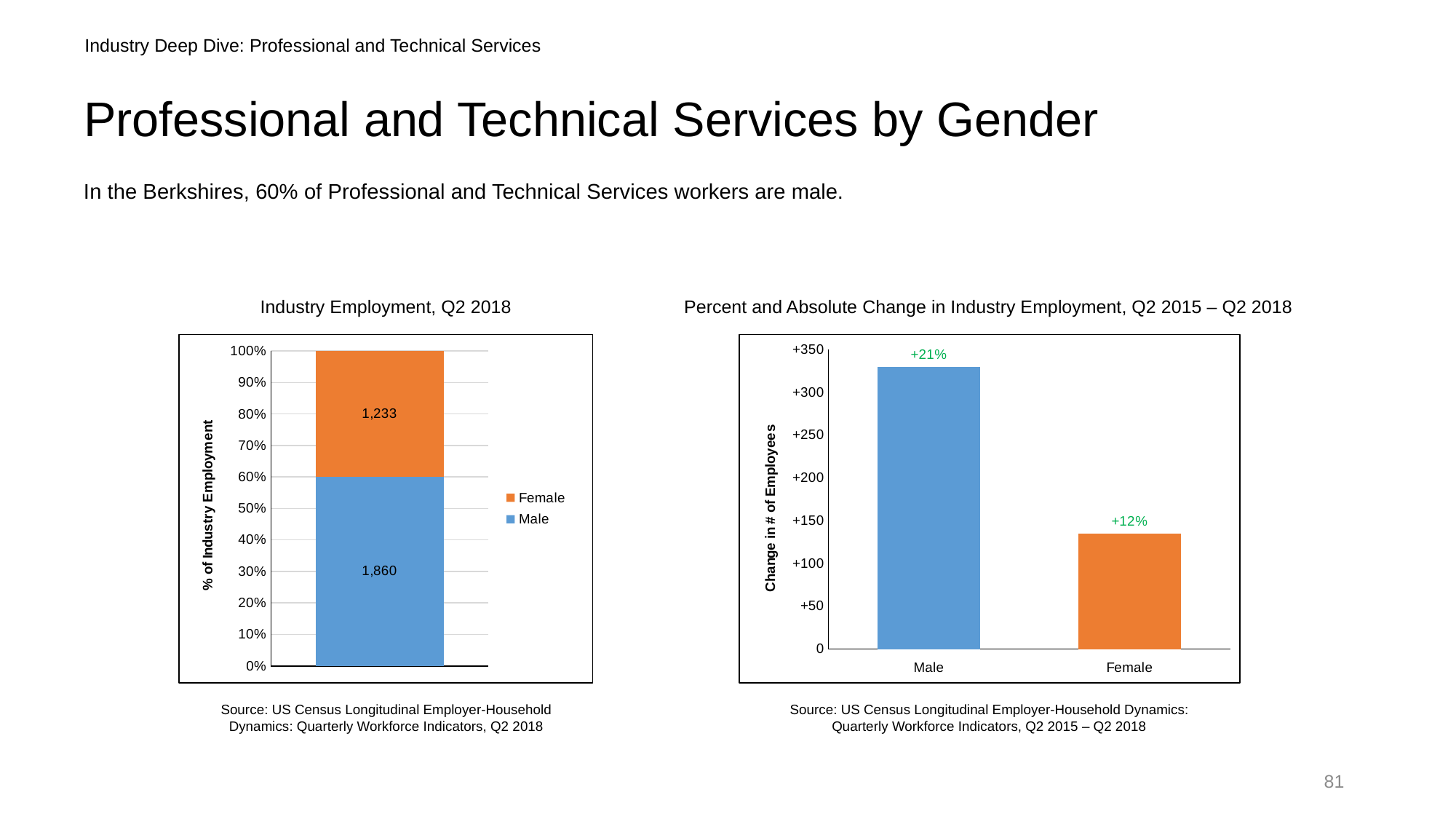
In the 'Industry Employment, Q2 2018' chart, how many series does the legend list? 2 In the 'Percent and Absolute Change in Industry Employment, Q2 2015 – Q2 2018' chart, what percent change is shown for Female? +12% In the 'Percent and Absolute Change in Industry Employment, Q2 2015 – Q2 2018' chart, how many categories are shown on the x axis? 2 In the 'Industry Employment, Q2 2018' chart, what is the difference between the Male and Female values? 627 In the 'Percent and Absolute Change in Industry Employment, Q2 2015 – Q2 2018' chart, is the change in number of employees for Female greater or less than +150? less In the 'Industry Employment, Q2 2018' chart, what is the value shown for Male? 1,860 In the 'Percent and Absolute Change in Industry Employment, Q2 2015 – Q2 2018' chart, what percent change is shown for Male? +21% In the 'Industry Employment, Q2 2018' chart, what colour represents Female? Orange In the 'Industry Employment, Q2 2018' chart, what is the total of the stacked bar? 3,093 In the 'Industry Employment, Q2 2018' chart, which series is larger, Male or Female? Male In the 'Industry Employment, Q2 2018' chart, what is the value shown for Female? 1,233 In the 'Percent and Absolute Change in Industry Employment, Q2 2015 – Q2 2018' chart, which category has the highest change in number of employees? Male